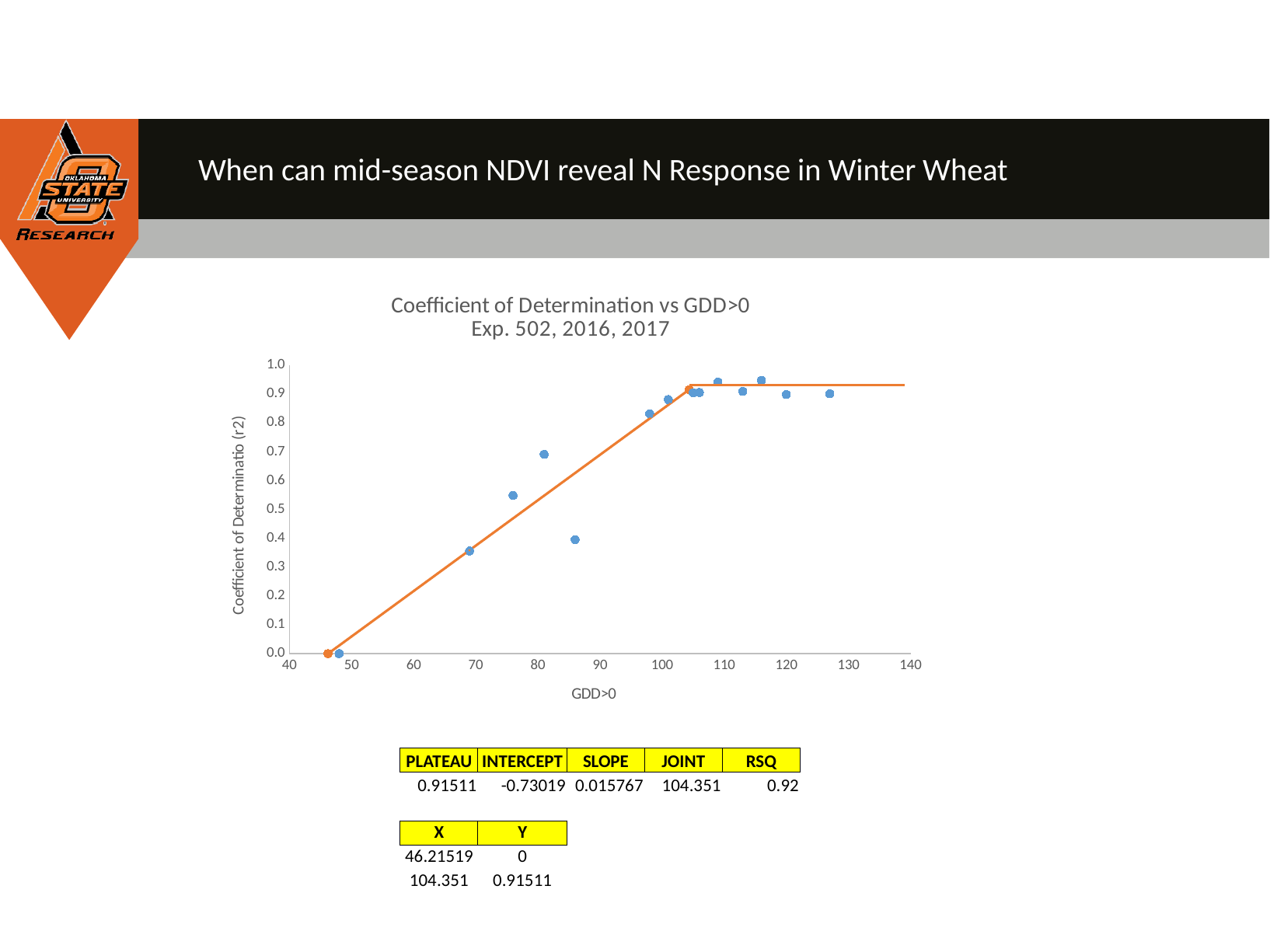
What is the title of the chart? Coefficient of Determination vs GDD>0 Exp. 502, 2016, 2017 Is the coefficient of determination for the point near GDD>0 of 98 greater or less than 0.7? greater What kind of chart is shown on the slide? scatter chart According to the table below the chart, what is the PLATEAU value of the fitted line? 0.91511 According to the table below the chart, what is the RSQ of the fitted line? 0.92 Is the coefficient of determination for the point near GDD>0 of 86 greater or less than 0.5? less According to the table below the chart, what is the JOINT value of the fitted line? 104.351 What is the label of the x axis of the chart? GDD>0 Overall, does the coefficient of determination rise or fall as GDD>0 increases from 40 to about 105? rise Are the coefficient of determination values for the points with GDD>0 above 110 greater or less than 0.8? greater Which point has the higher coefficient of determination: the one near GDD>0 of 81 or the one near GDD>0 of 86? the point near GDD>0 of 81